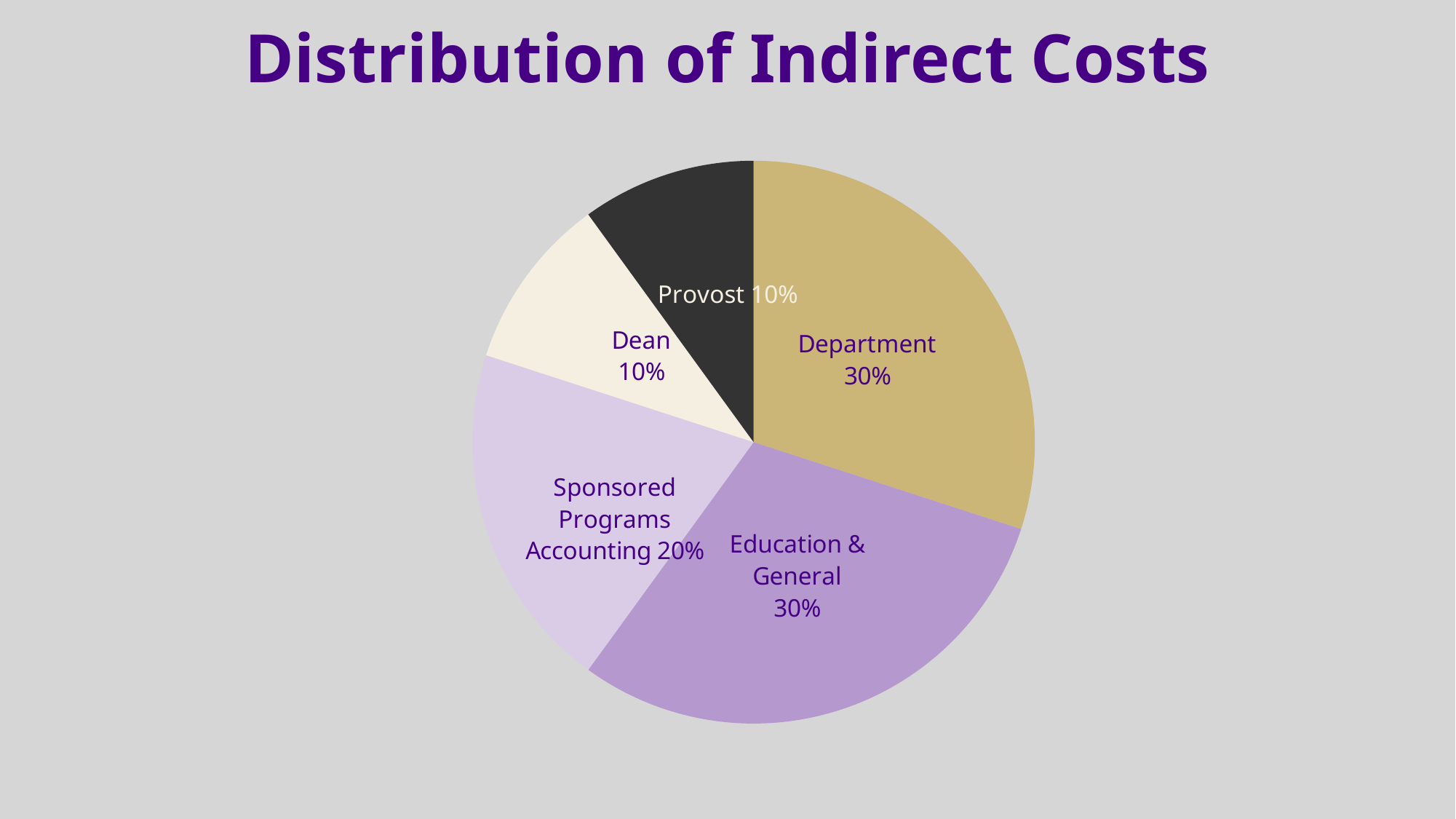
What share of indirect costs goes to the Dean? 10% What share of indirect costs goes to the Department? 30% Which slice is larger, Sponsored Programs Accounting or Dean? Sponsored Programs Accounting How many slices does the pie chart have? 5 What is the difference between the Education & General share and the Sponsored Programs Accounting share? 10% What colour is the Provost slice? Black What share of indirect costs goes to Education & General? 30% What share of indirect costs goes to the Provost? 10% What is the title of the chart? Distribution of Indirect Costs What kind of chart is shown on the slide? Pie chart What is the difference between the Department share and the Provost share? 20% What share of indirect costs goes to Sponsored Programs Accounting? 20%